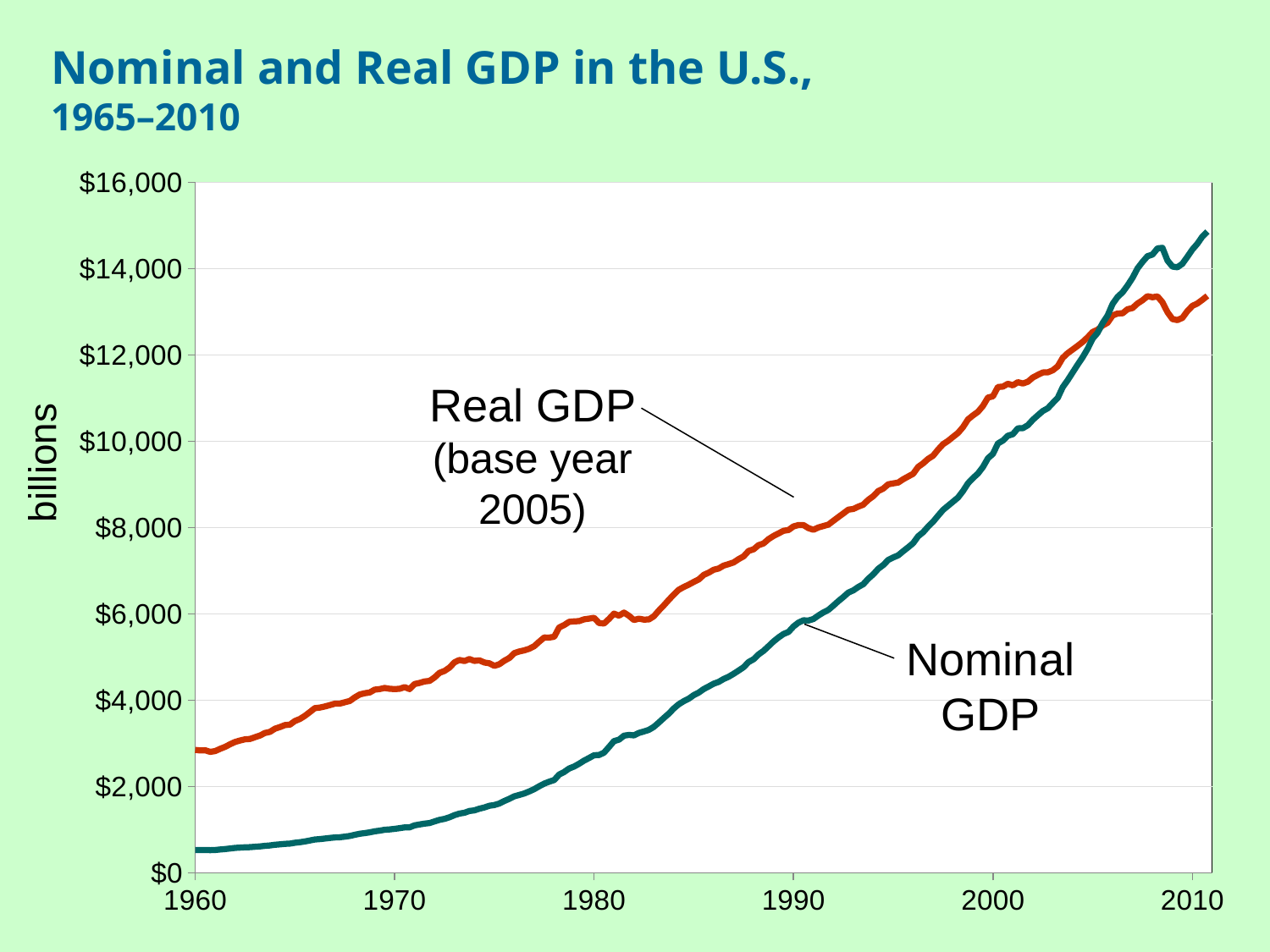
Is the value of Real GDP in 1980 greater or less than $8,000? less Is the value of Real GDP in 1990 greater or less than $6,000? greater In 1980, which series has the larger value, Real GDP or Nominal GDP? Real GDP Is the value of Real GDP in 1960 greater or less than $2,000? greater What is the label on the vertical axis? billions How many series are plotted on the chart? 2 What is the title of the chart? Nominal and Real GDP in the U.S., 1965–2010 In 2010, which series has the larger value, Real GDP or Nominal GDP? Nominal GDP What kind of chart is shown on the slide? line chart